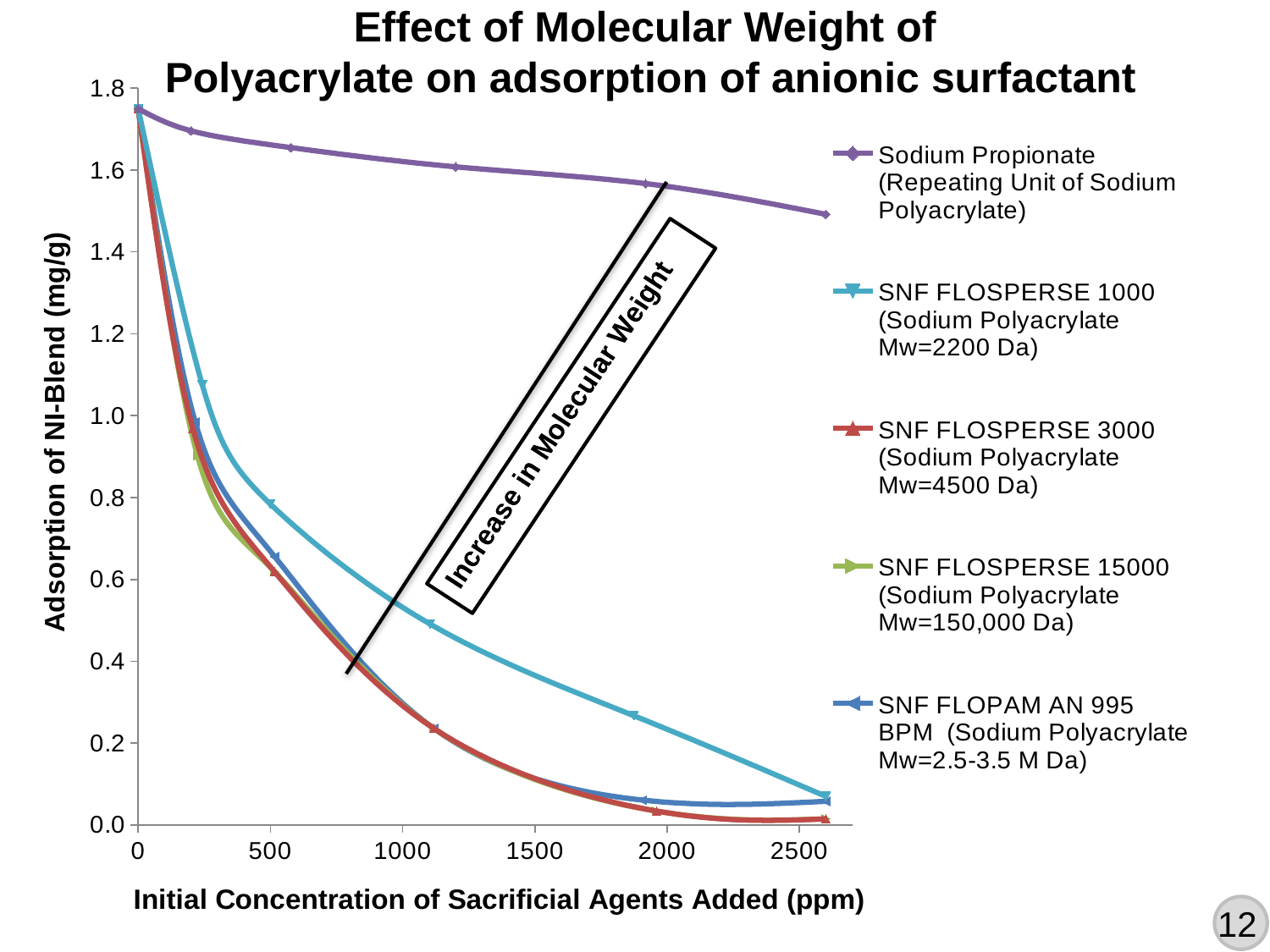
Which series has the highest adsorption at 2500 ppm? Sodium Propionate (Repeating Unit of Sodium Polyacrylate) At about 500 ppm, which has the higher adsorption: Sodium Propionate or SNF FLOSPERSE 1000? Sodium Propionate What is the highest value shown on the y axis? 1.8 At about 2500 ppm, which has the higher adsorption: SNF FLOSPERSE 1000 or SNF FLOSPERSE 3000? SNF FLOSPERSE 1000 Is the adsorption for Sodium Propionate at about 2500 ppm greater or less than 1.4 mg/g? greater What kind of chart is shown on the slide? Line chart Does the adsorption for Sodium Propionate rise or fall as the initial concentration increases? Fall What is the title of the chart? Effect of Molecular Weight of Polyacrylate on adsorption of anionic surfactant Is the adsorption for SNF FLOPAM AN 995 BPM at about 2500 ppm greater or less than 0.2 mg/g? less What is the label of the x axis? Initial Concentration of Sacrificial Agents Added (ppm) Is the adsorption for SNF FLOSPERSE 1000 at about 500 ppm greater or less than 1.0 mg/g? less How many series does the legend list? 5